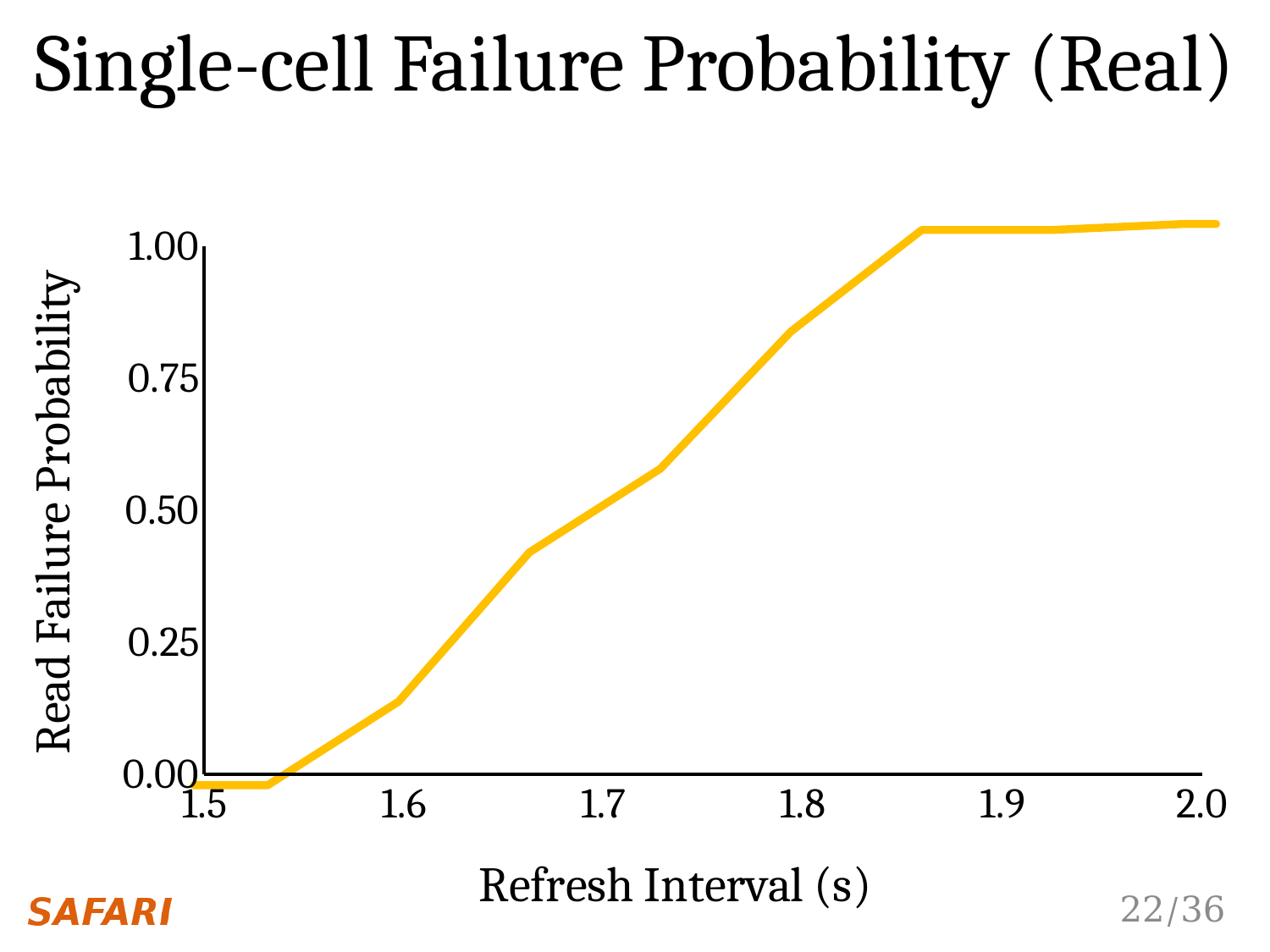
Does the read failure probability rise or fall as the refresh interval increases from 1.5 to 2.0 s? rise How many lines are plotted on the chart? 1 Is the read failure probability at a refresh interval of 1.5 s greater or less than 0.25? less Is the read failure probability at a refresh interval of 1.8 s greater or less than 0.75? greater Is the read failure probability at a refresh interval of 1.6 s greater or less than 0.25? less What kind of chart is shown on the slide? line chart Which is larger: the read failure probability at 1.6 s or at 1.8 s? 1.8 s What is the label of the x axis? Refresh Interval (s) At which labelled refresh interval on the x axis is the read failure probability lowest? 1.5 What is the title of the slide's chart? Single-cell Failure Probability (Real)